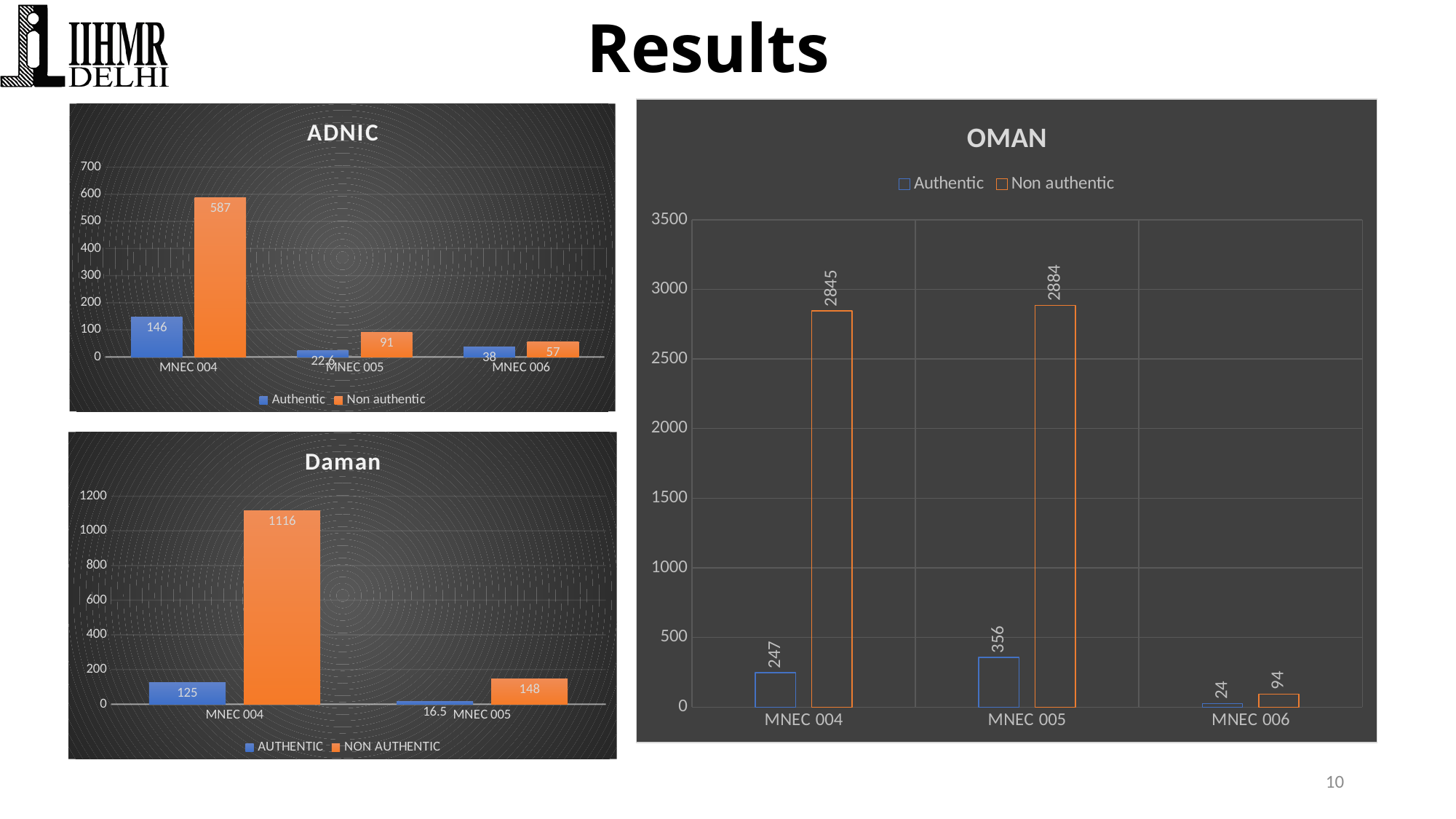
In the ADNIC chart, what is the Non authentic value for MNEC 004? 587 In the ADNIC chart, what is the difference between the Non authentic and Authentic values for MNEC 006? 19 In the OMAN chart, what is the Non authentic value for MNEC 005? 2884 In the OMAN chart, which category has the lowest Authentic value? MNEC 006 How many series does the legend of the OMAN chart list? 2 How many categories are shown in the Daman chart? 2 In the OMAN chart, what is the difference between the Non authentic and Authentic values for MNEC 004? 2598 In the OMAN chart, is the Authentic value for MNEC 005 larger or smaller than the Authentic value for MNEC 004? larger In the Daman chart, what is the NON AUTHENTIC value for MNEC 004? 1116 In the ADNIC chart, what is the Authentic value for MNEC 005? 22.6 In the ADNIC chart, which category has the highest Non authentic value? MNEC 004 In the Daman chart, what is the AUTHENTIC value for MNEC 005? 16.5